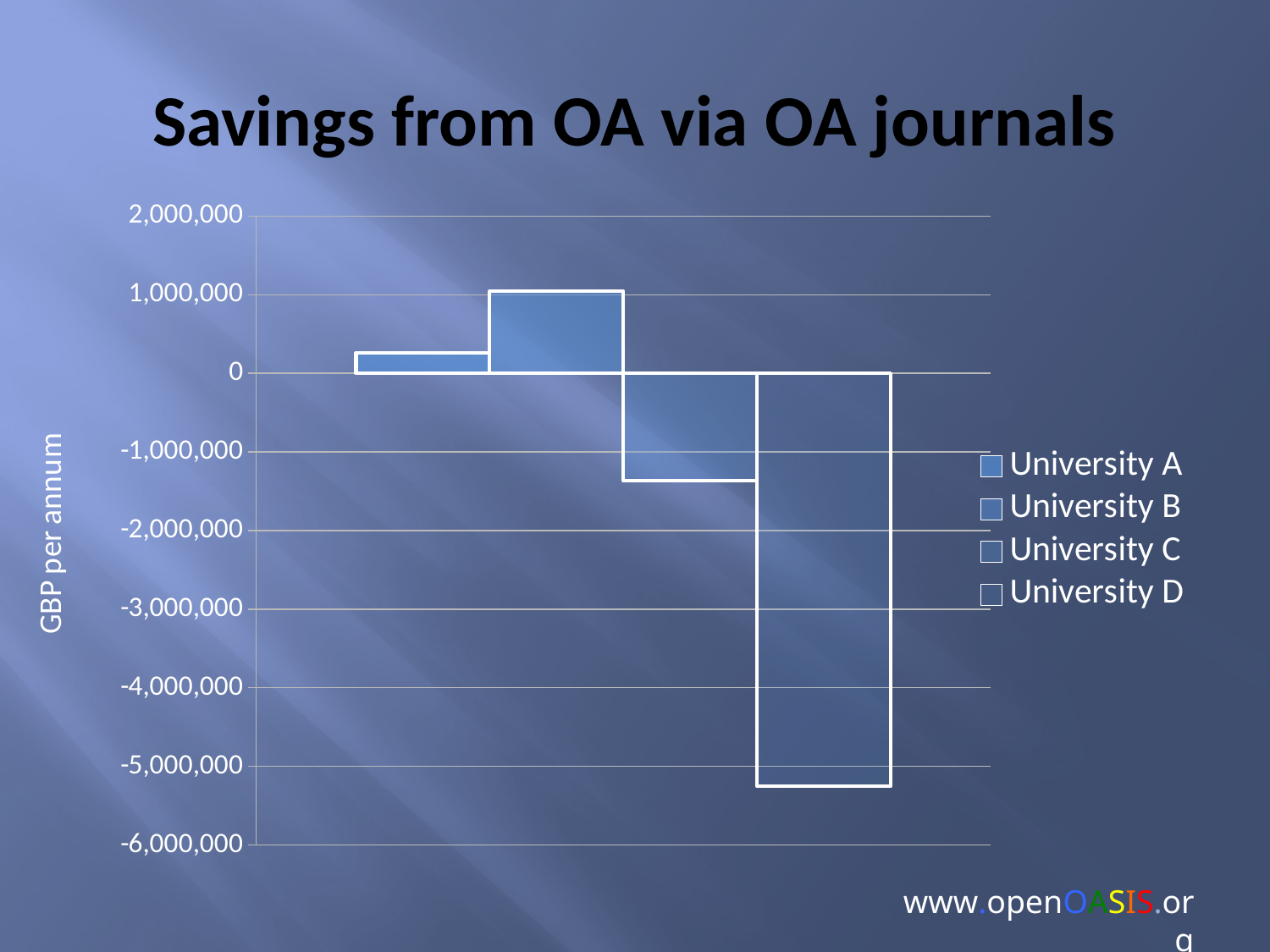
How many series does the legend list? 4 Which university has the lowest savings value? University D Is the value for University D greater or less than -5,000,000? less Is the value for University A greater or less than 0? greater Is the value for University A greater or less than 1,000,000? less Which is larger, the value for University C or the value for University D? University C Which university has the highest savings value? University B What is the title of the chart? Savings from OA via OA journals Which is larger, the value for University A or the value for University B? University B How many bars are plotted in the chart? 4 What kind of chart is shown on the slide? bar chart